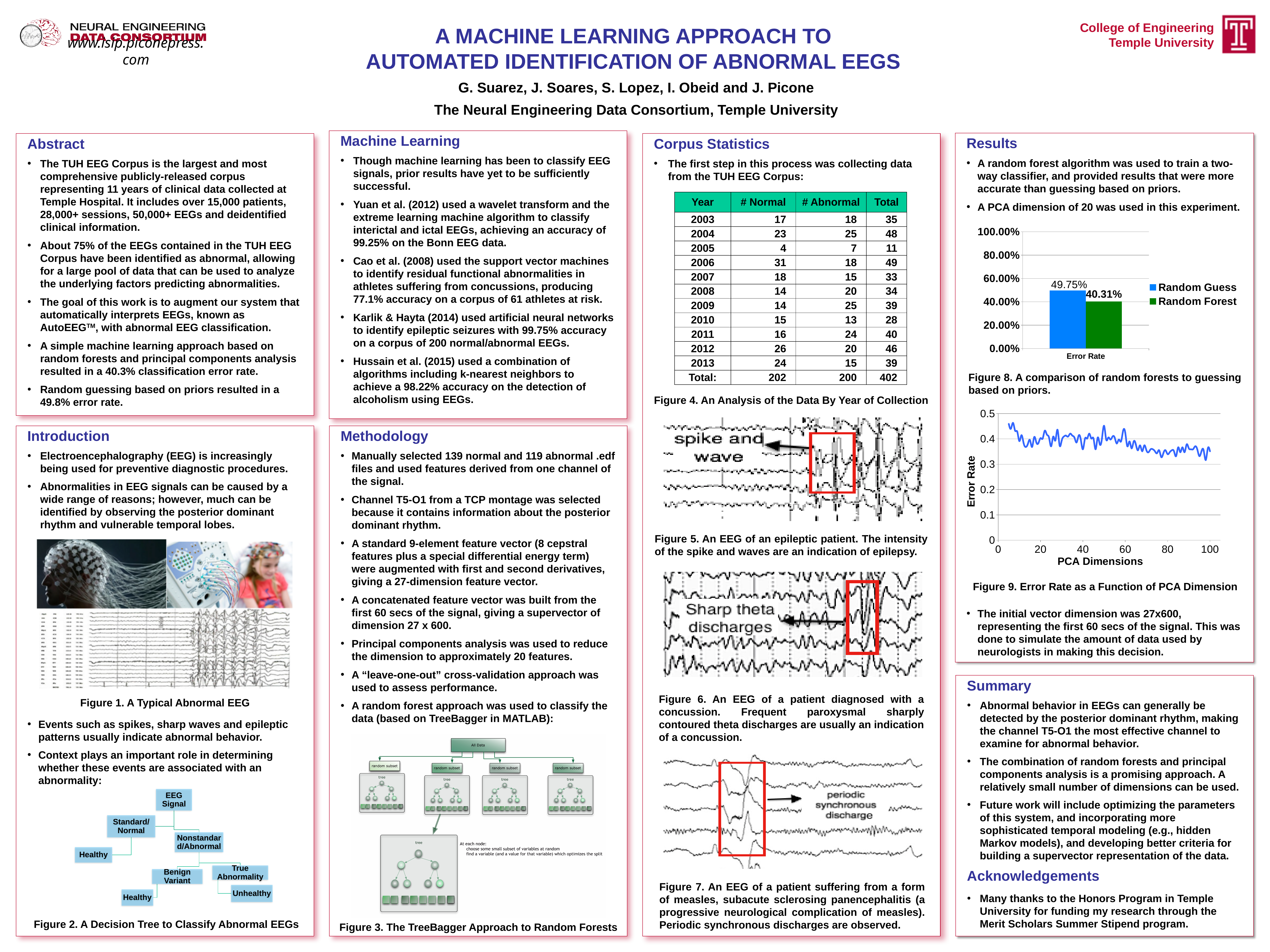
In the Figure 9 line chart, is the error rate at 100 PCA dimensions greater or less than 0.4? less How many series does the legend of the Figure 8 chart list? 2 In the Figure 8 bar chart, what is the error rate for Random Guess? 49.75% In the Figure 8 bar chart, is the Random Forest error rate greater or less than 60.00%? less In the Figure 8 bar chart, what colour is the Random Forest bar? Green What kind of chart is Figure 9 (Error Rate as a Function of PCA Dimension)? Line chart In the Figure 8 bar chart, what is the difference between the Random Guess and Random Forest error rates? 9.44% What kind of chart is Figure 8? Bar chart In the Figure 8 bar chart, which series has the lowest error rate? Random Forest In the Figure 8 bar chart, which series has the higher error rate, Random Guess or Random Forest? Random Guess In the Figure 9 line chart, does the error rate generally rise or fall as PCA dimensions increase? Fall In the Figure 8 bar chart, what is the error rate for Random Forest? 40.31%